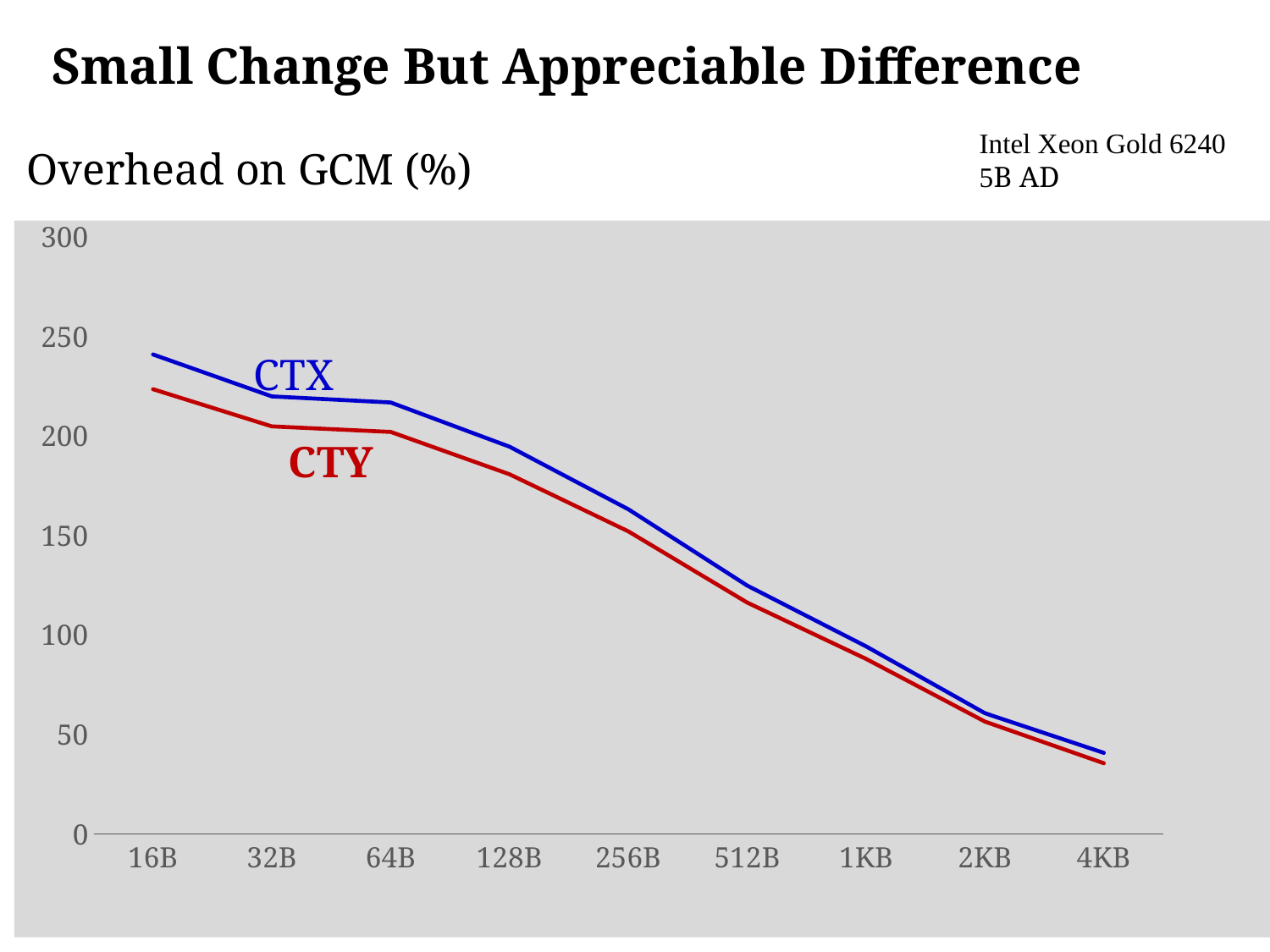
How many series are plotted in the chart? 2 Is the CTX value at 16B greater or less than 200? greater At 16B, which series has the higher overhead, CTX or CTY? CTX Is the CTX value at 512B greater or less than 100? greater Do the CTX values rise or fall as the message size increases from 16B to 4KB? fall Is the CTY value at 4KB greater or less than 50? less How many message-size categories are shown on the x axis? 9 At which message size is the CTX overhead lowest? 4KB What colour is the CTY line? red At which message size is the CTY overhead highest? 16B What kind of chart is shown on the slide? line chart